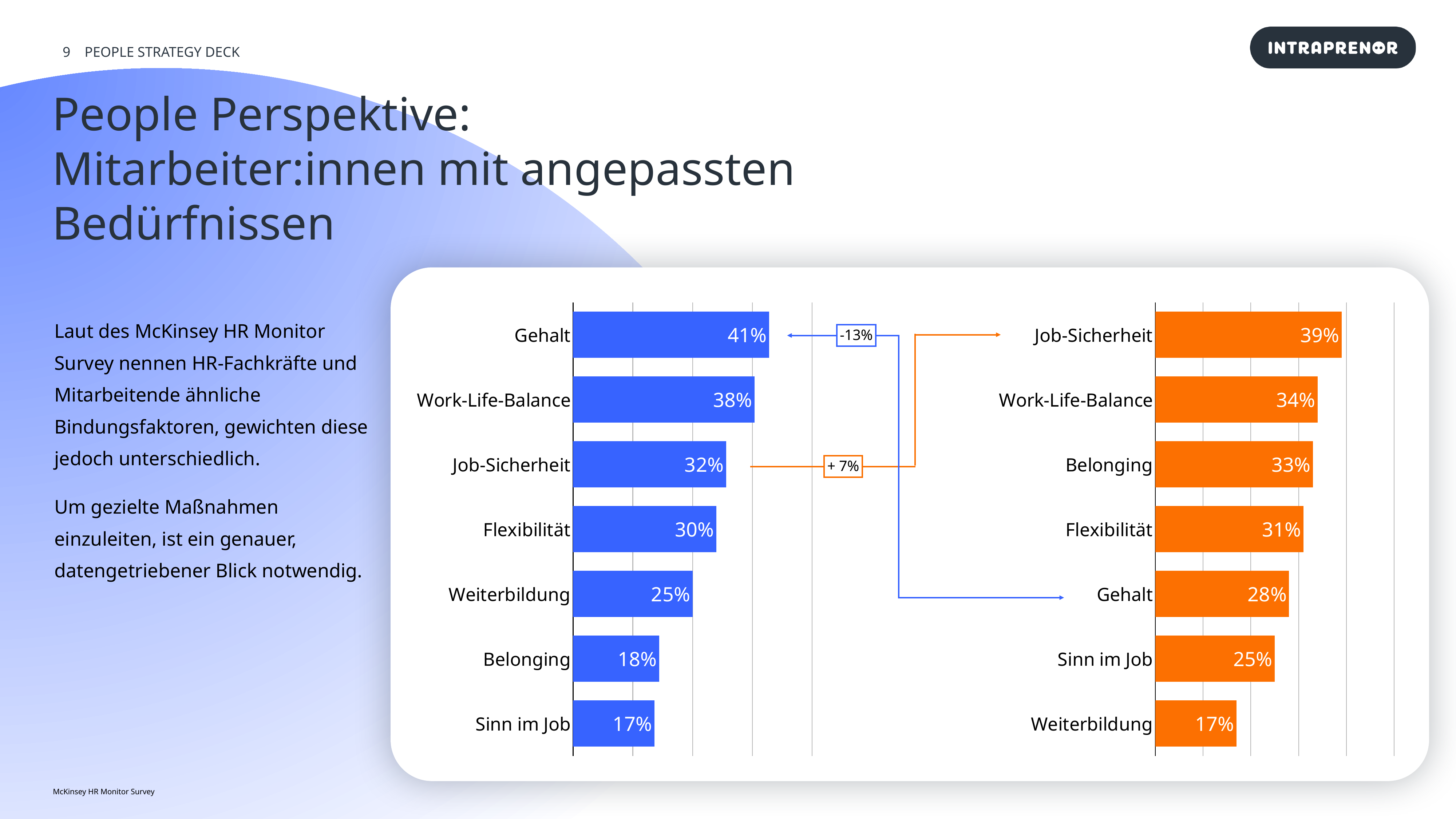
In the left (blue) bar chart, what is the value for Gehalt? 41% What is the difference between the value for Gehalt in the left (blue) chart and the value for Gehalt in the right (orange) chart? 13% In the left (blue) bar chart, which category has the lowest value? Sinn im Job In the right (orange) bar chart, what is the value for Sinn im Job? 25% What type of chart is the right (orange) chart? Bar chart In the right (orange) bar chart, which category has the highest value? Job-Sicherheit Which is larger: Job-Sicherheit in the left (blue) chart or Job-Sicherheit in the right (orange) chart? Job-Sicherheit in the right (orange) chart In the left (blue) bar chart, what is the difference between Work-Life-Balance and Weiterbildung? 13% In the right (orange) bar chart, which category has the lowest value? Weiterbildung How many categories does the left (blue) bar chart show? 7 In the right (orange) bar chart, what is the value for Belonging? 33% In the left (blue) bar chart, which is larger: Flexibilität or Belonging? Flexibilität